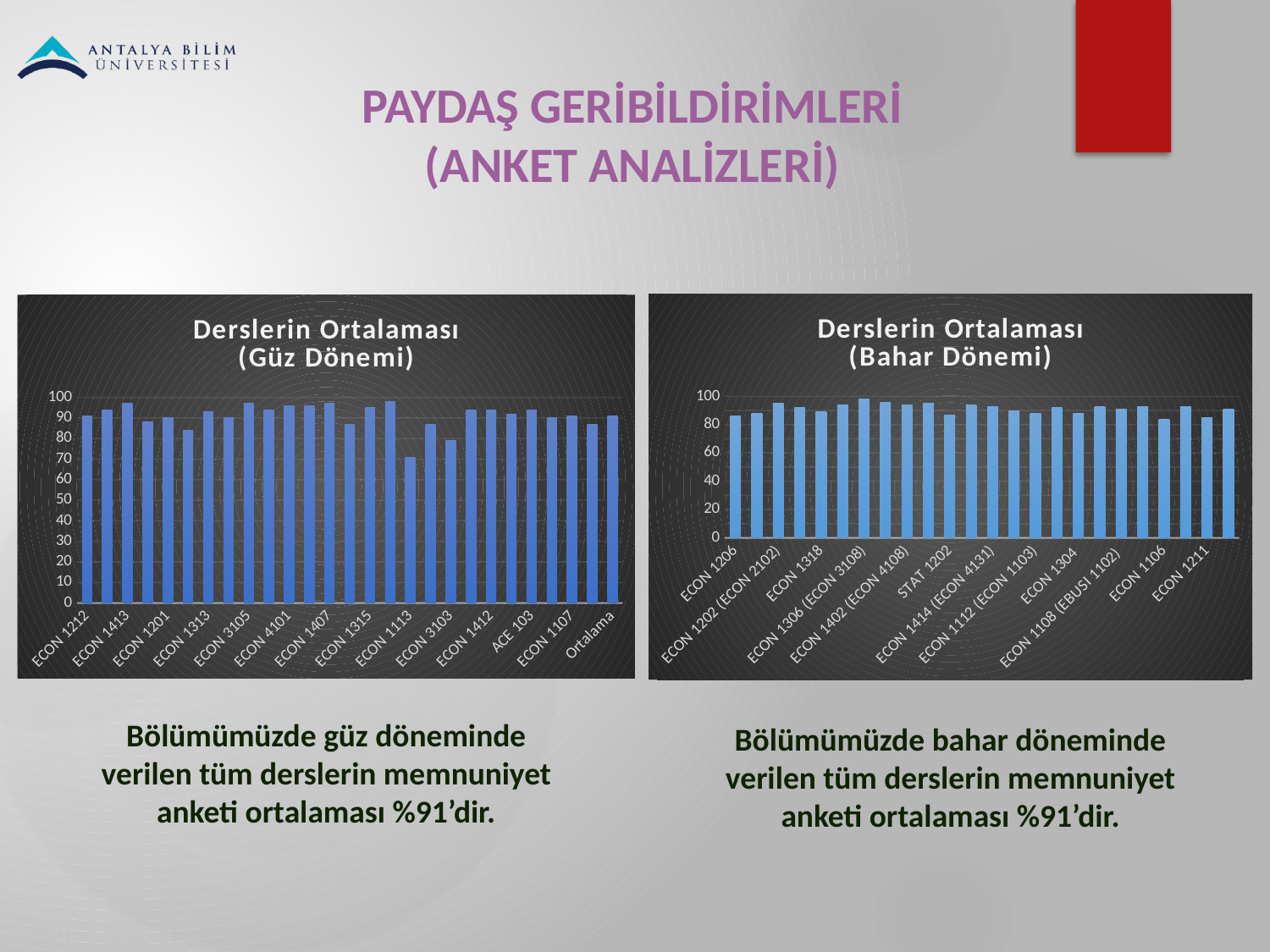
What kind of chart is the 'Derslerin Ortalaması (Bahar Dönemi)' chart? bar chart What is the title of the chart on the right side of the slide? Derslerin Ortalaması (Bahar Dönemi) In the 'Derslerin Ortalaması (Bahar Dönemi)' chart, is the value for ECON 1211 greater or less than 80? greater In the 'Derslerin Ortalaması (Güz Dönemi)' chart, is the value for Ortalama greater or less than 80? greater In the 'Derslerin Ortalaması (Güz Dönemi)' chart, is the value for ECON 1212 greater or less than 80? greater What kind of chart is the 'Derslerin Ortalaması (Güz Dönemi)' chart? bar chart What is the title of the chart on the left side of the slide? Derslerin Ortalaması (Güz Dönemi)